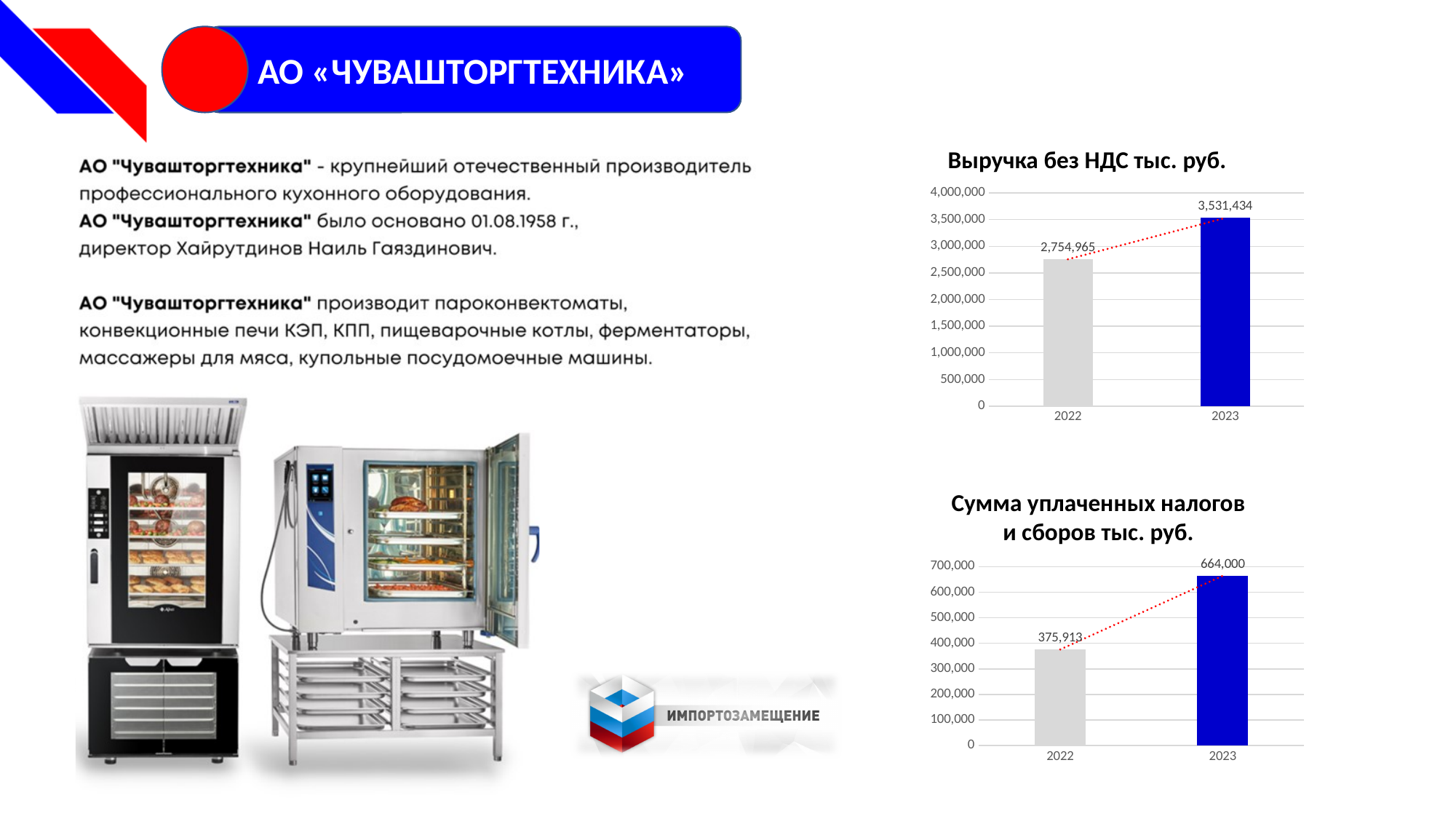
In the chart titled "Сумма уплаченных налогов и сборов тыс. руб.", which year has the lower value? 2022 In the chart titled "Выручка без НДС тыс. руб.", which year has the higher value? 2023 In the chart titled "Сумма уплаченных налогов и сборов тыс. руб.", how many years are shown on the x axis? 2 What kind of chart is the one titled "Выручка без НДС тыс. руб."? bar chart In the chart titled "Сумма уплаченных налогов и сборов тыс. руб.", what is the value for 2022? 375,913 In the chart titled "Выручка без НДС тыс. руб.", what is the value for 2022? 2,754,965 In the chart titled "Выручка без НДС тыс. руб.", what is the difference between the 2023 and 2022 values? 776,469 In the chart titled "Сумма уплаченных налогов и сборов тыс. руб.", what is the difference between the 2023 and 2022 values? 288,087 In the chart titled "Выручка без НДС тыс. руб.", is the value for 2022 greater or less than 3,000,000? less In the chart titled "Выручка без НДС тыс. руб.", what is the value for 2023? 3,531,434 In the chart titled "Сумма уплаченных налогов и сборов тыс. руб.", what is the value for 2023? 664,000 In the chart titled "Сумма уплаченных налогов и сборов тыс. руб.", do the values rise or fall from 2022 to 2023? rise